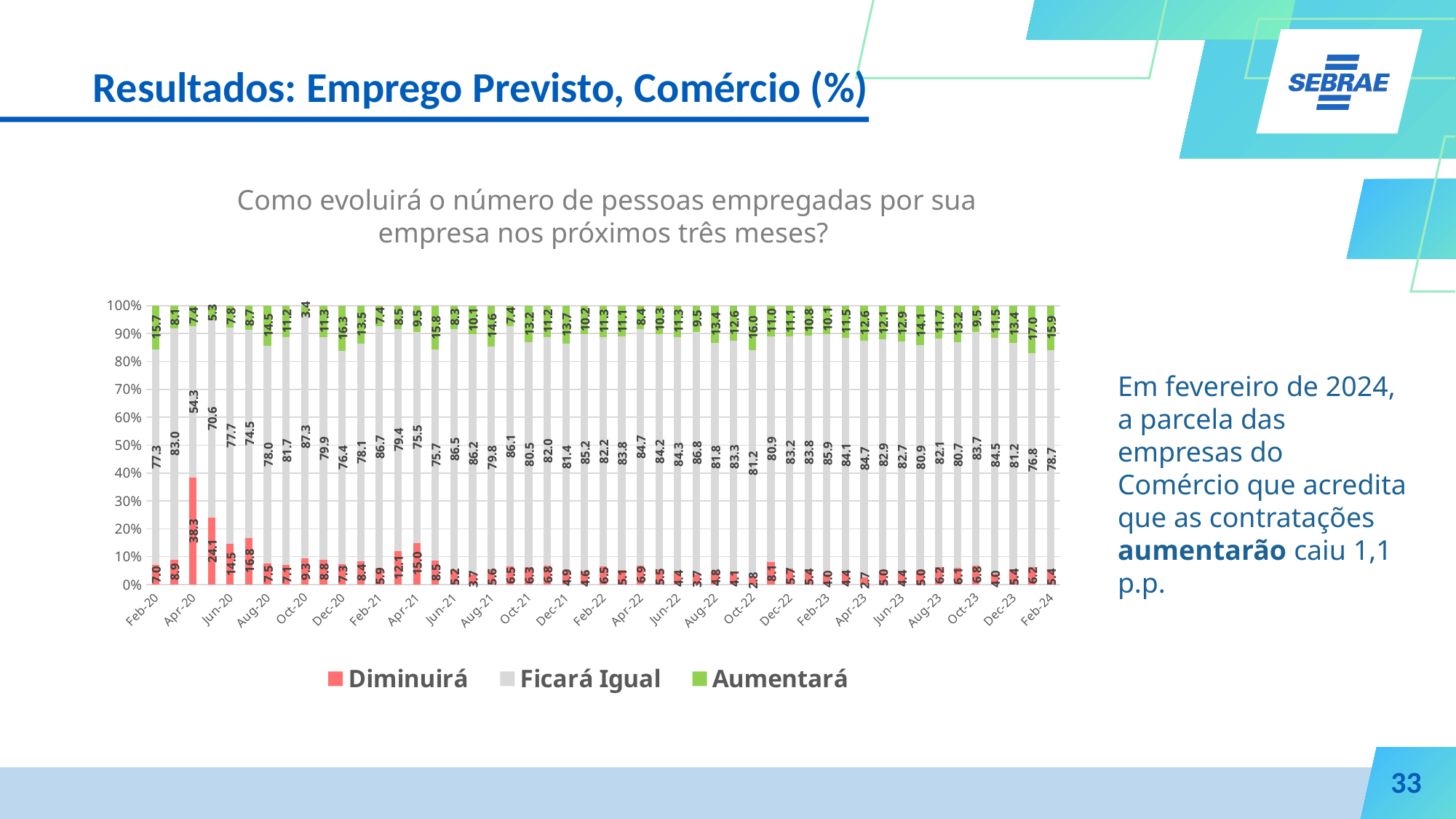
What is the Aumentará value for Feb-24? 15.9 What is the Ficará Igual value for Feb-20? 77.3 In which month is the Ficará Igual value lowest? Apr-20 What is the difference between the Aumentará values for Feb-24 and Feb-20? 0.2 Which is larger, the Diminuirá value for Feb-20 or for Feb-24? Feb-20 How many series does the chart legend list? 3 In which month is the Diminuirá value highest? Apr-20 What is the Ficará Igual value for Feb-24? 78.7 In which month is the Aumentará value lowest? Oct-20 What are the three series listed in the chart legend? Diminuirá, Ficará Igual, Aumentará What kind of chart is shown on the slide? Stacked bar chart What is the Diminuirá value for Apr-20? 38.3